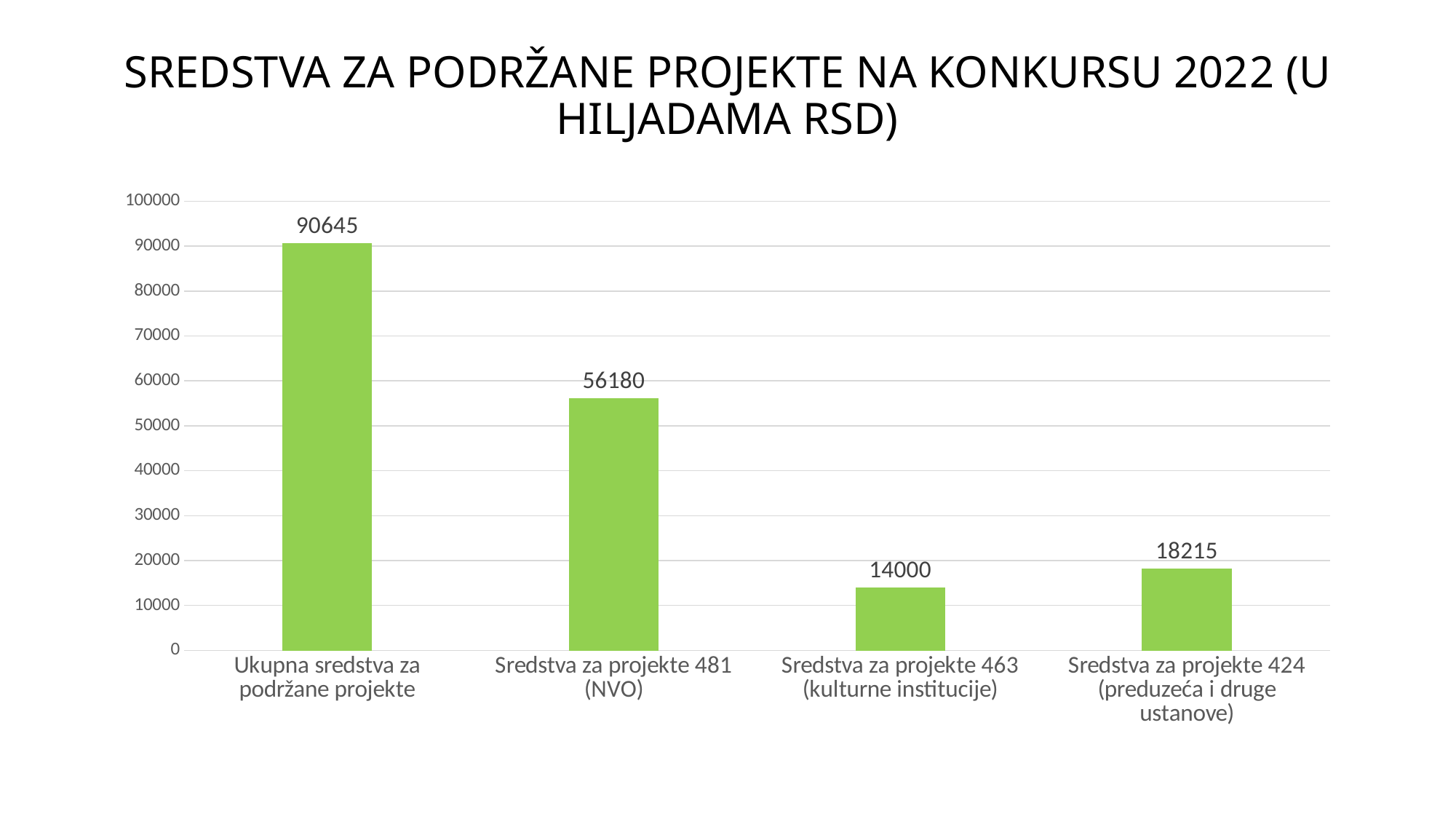
Which is larger: the value for 'Sredstva za projekte 424 (preduzeća i druge ustanove)' or 'Sredstva za projekte 463 (kulturne institucije)'? Sredstva za projekte 424 (preduzeća i druge ustanove) What is the value for 'Sredstva za projekte 424 (preduzeća i druge ustanove)'? 18215 What is the title of the chart? SREDSTVA ZA PODRŽANE PROJEKTE NA KONKURSU 2022 (U HILJADAMA RSD) What is the value for 'Ukupna sredstva za podržane projekte'? 90645 What is the difference between the values for 'Sredstva za projekte 481 (NVO)' and 'Sredstva za projekte 424 (preduzeća i druge ustanove)'? 37965 What is the value for 'Sredstva za projekte 463 (kulturne institucije)'? 14000 Is the value for 'Sredstva za projekte 481 (NVO)' greater or less than 50000? greater How many categories are shown on the chart? 4 Which category has the highest value? Ukupna sredstva za podržane projekte Which category has the lowest value? Sredstva za projekte 463 (kulturne institucije) What kind of chart is shown on the slide? bar chart What is the value for 'Sredstva za projekte 481 (NVO)'? 56180